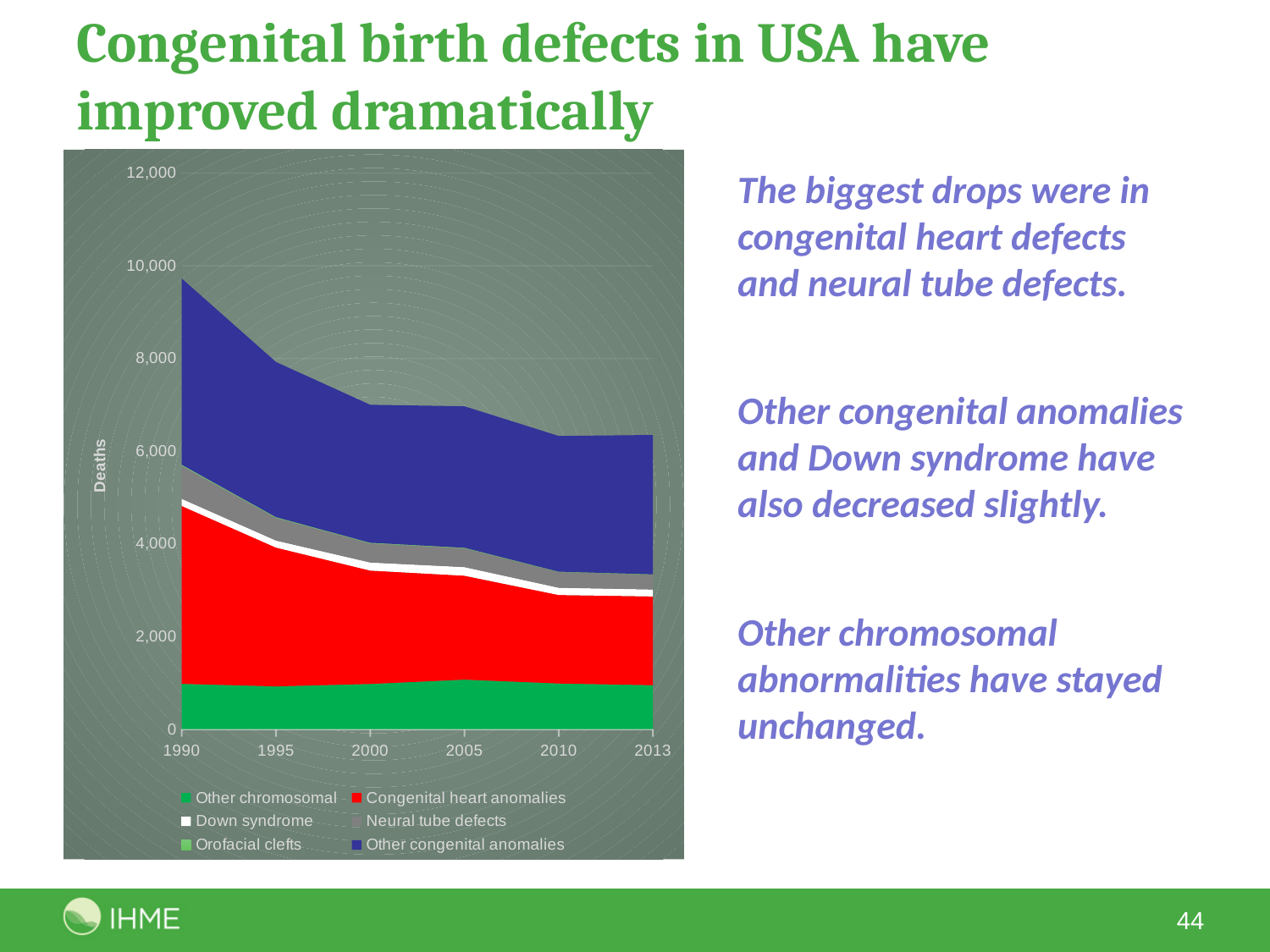
Which year has the larger total number of deaths, 1990 or 2013? 1990 In which year is the total number of deaths highest in the chart? 1990 How many series does the chart's legend list? 6 Do total deaths rise or fall from 1990 to 2013 in the chart? Fall Is the number of deaths from Other chromosomal in 1990 greater or less than 2,000? less Is the total number of deaths in 1990 greater or less than 8,000? greater What kind of chart is shown on the slide? Stacked area chart Is the total number of deaths in 2013 greater or less than 8,000? less Which series is shown in red in the chart? Congenital heart anomalies What is the label on the y axis of the chart? Deaths How many years are labelled on the x axis of the chart? 6